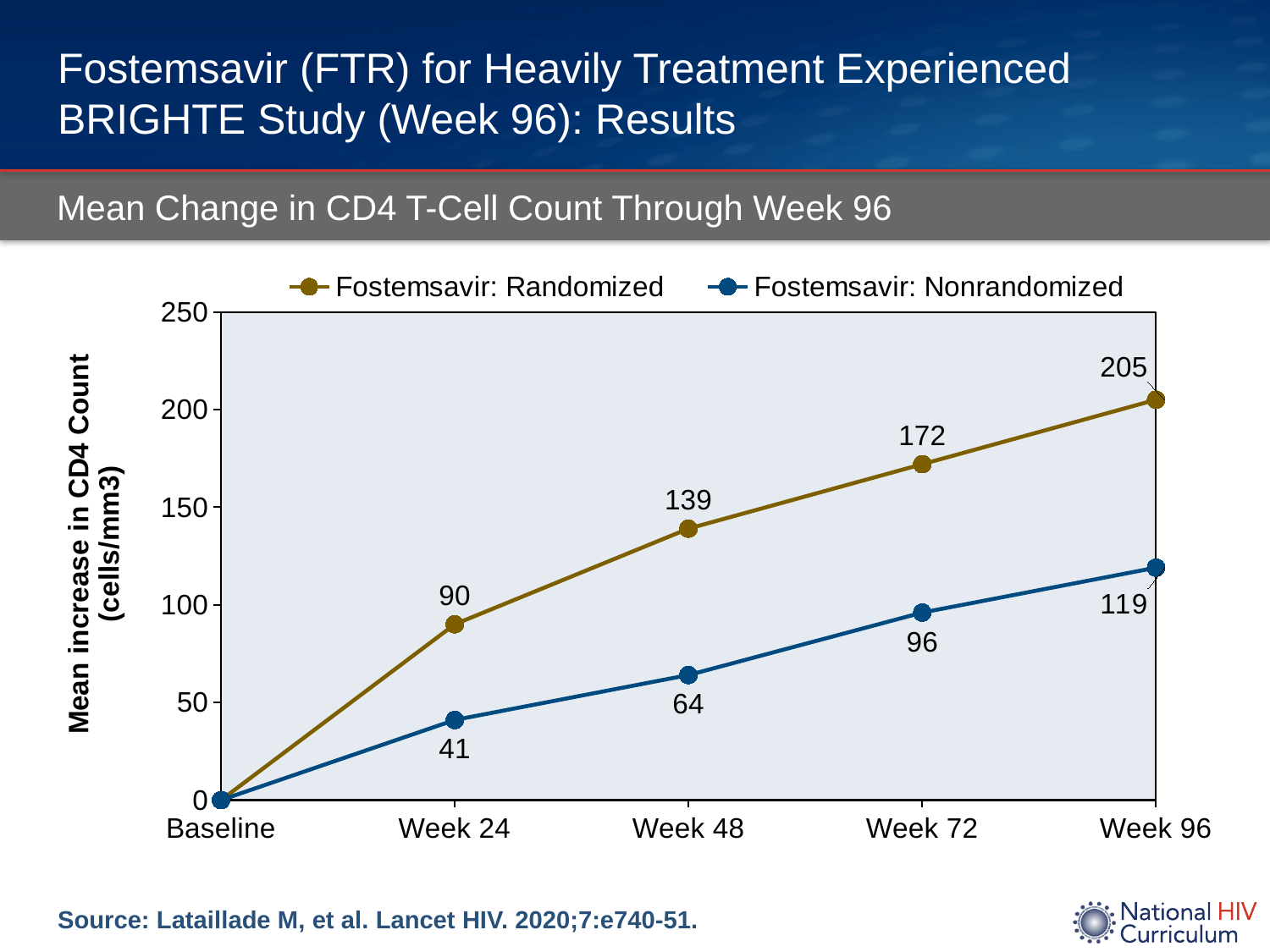
What is the mean increase in CD4 count for Fostemsavir: Randomized at Week 96? 205 What is the value for Fostemsavir: Randomized at Week 24? 90 What is the value for Fostemsavir: Nonrandomized at Week 72? 96 What is the difference between the Randomized values at Week 72 and Week 48? 33 What kind of chart is shown on the slide? Line chart Which series has the larger value at Week 24, Randomized or Nonrandomized? Fostemsavir: Randomized Do the values for Fostemsavir: Nonrandomized rise or fall from Baseline to Week 96? Rise How many time points are shown on the x axis? 5 At which time point does the Fostemsavir: Randomized series reach its highest value? Week 96 How many series does the legend list? 2 What is the difference between the Randomized and Nonrandomized values at Week 96? 86 What is the mean increase in CD4 count for Fostemsavir: Nonrandomized at Week 48? 64